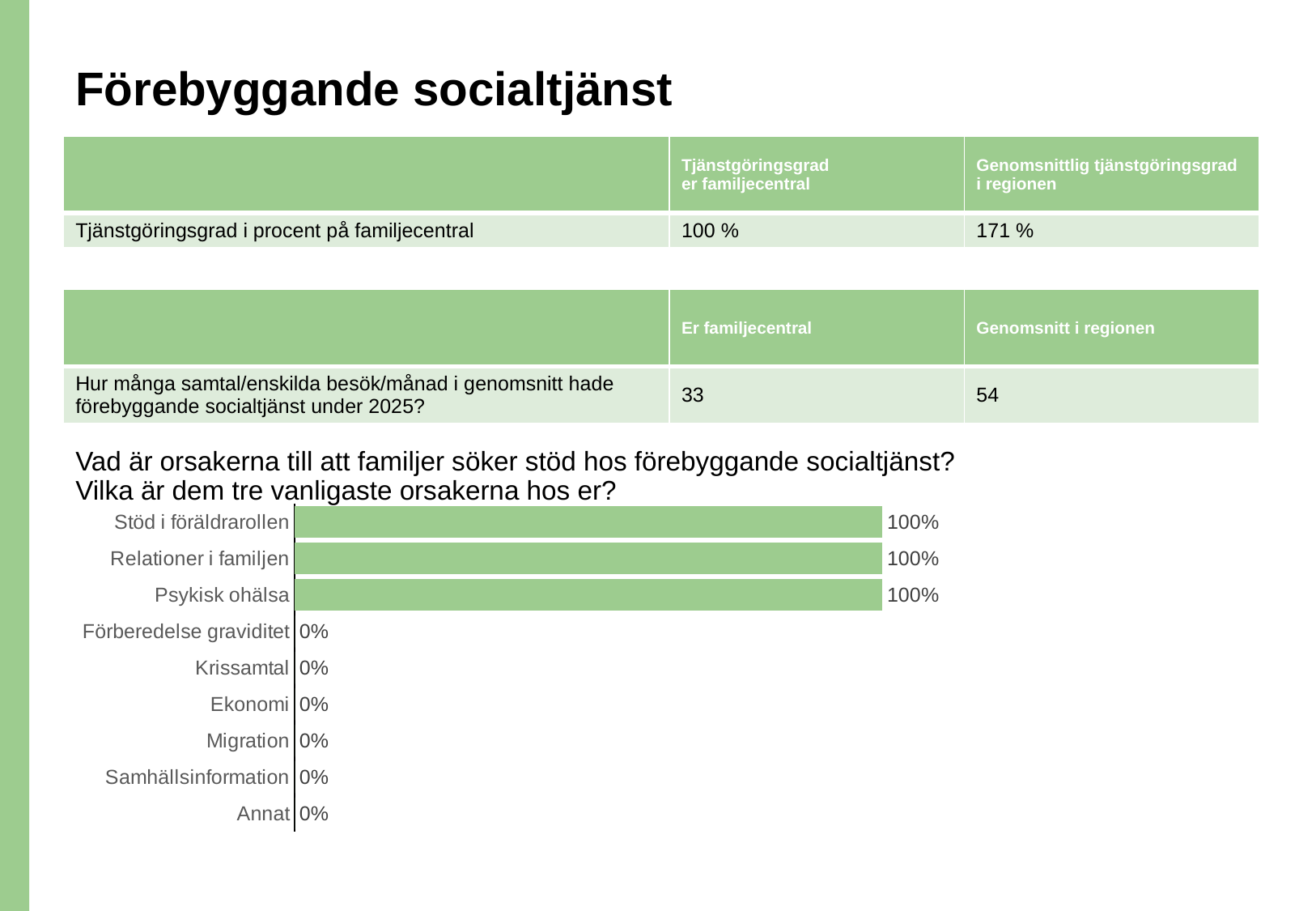
What kind of chart is shown at the bottom of the slide? bar chart What is the difference between the values for Psykisk ohälsa and Samhällsinformation in the bar chart? 100% Which is larger in the bar chart, Relationer i familjen or Krissamtal? Relationer i familjen What is the value for Ekonomi in the bar chart? 0% How many categories in the bar chart have a value of 100%? 3 What is the value for Stöd i föräldrarollen in the bar chart? 100% What is the first category listed at the top of the bar chart? Stöd i föräldrarollen How many categories does the bar chart show? 9 What is the value for Annat in the bar chart? 0% How many categories in the bar chart have a value of 0%? 6 What is the value for Migration in the bar chart? 0% What is the value for Psykisk ohälsa in the bar chart? 100%